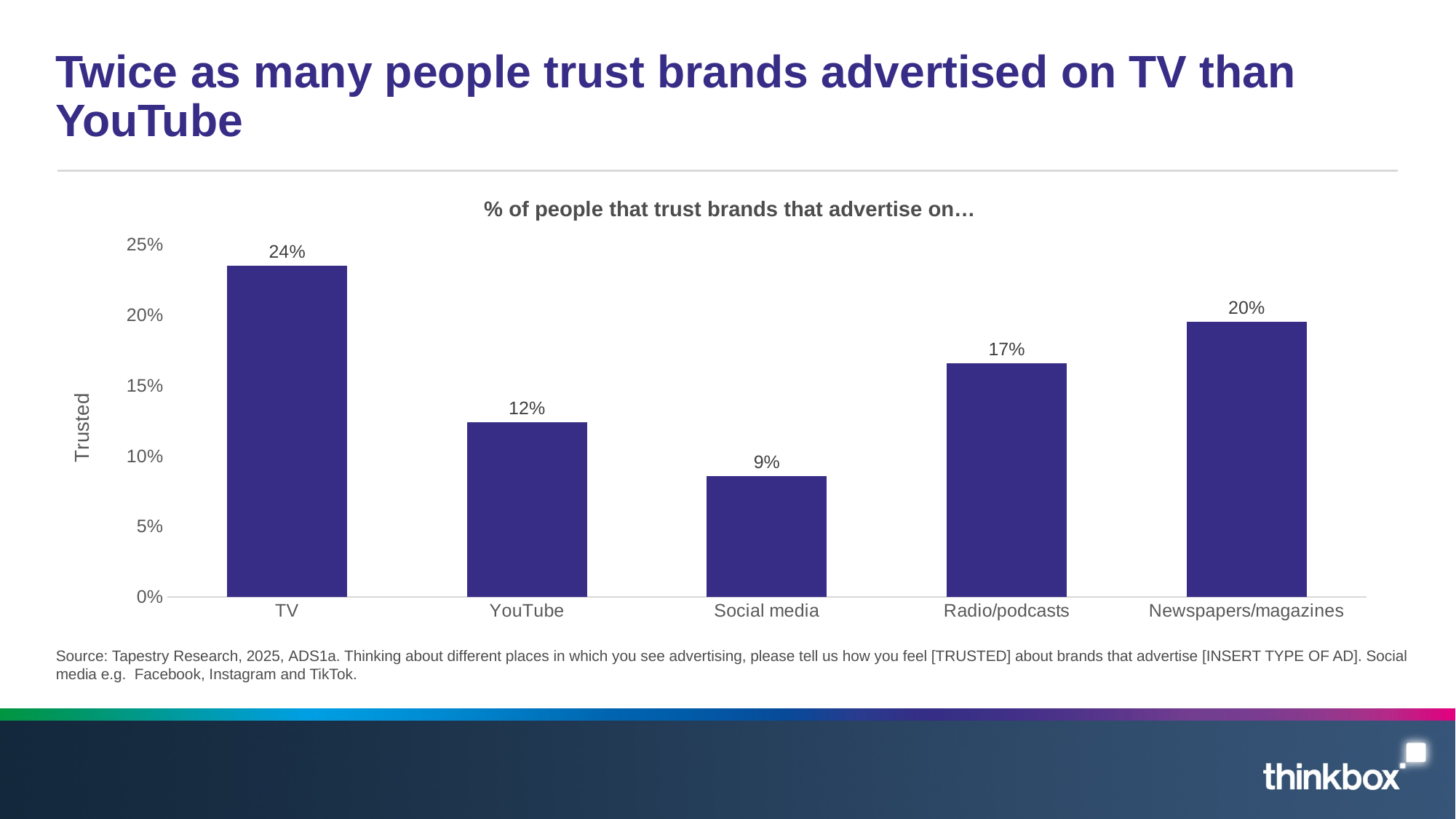
Which category has the lowest percentage of people trusting brands advertised on it? Social media Which is larger, the value for Newspapers/magazines or the value for Radio/podcasts? Newspapers/magazines Which category has the highest percentage of people trusting brands advertised on it? TV What percentage of people trust brands that advertise on Radio/podcasts? 17% What is the title of the chart? % of people that trust brands that advertise on… What kind of chart is shown on the slide? Bar chart How many categories are shown on the x axis of the chart? 5 Is the value for YouTube greater or less than 15%? less What percentage of people trust brands that advertise on Social media? 9% What is the label on the vertical axis of the chart? Trusted What is the difference in percentage points between TV and YouTube? 12 What percentage of people trust brands that advertise on TV? 24%